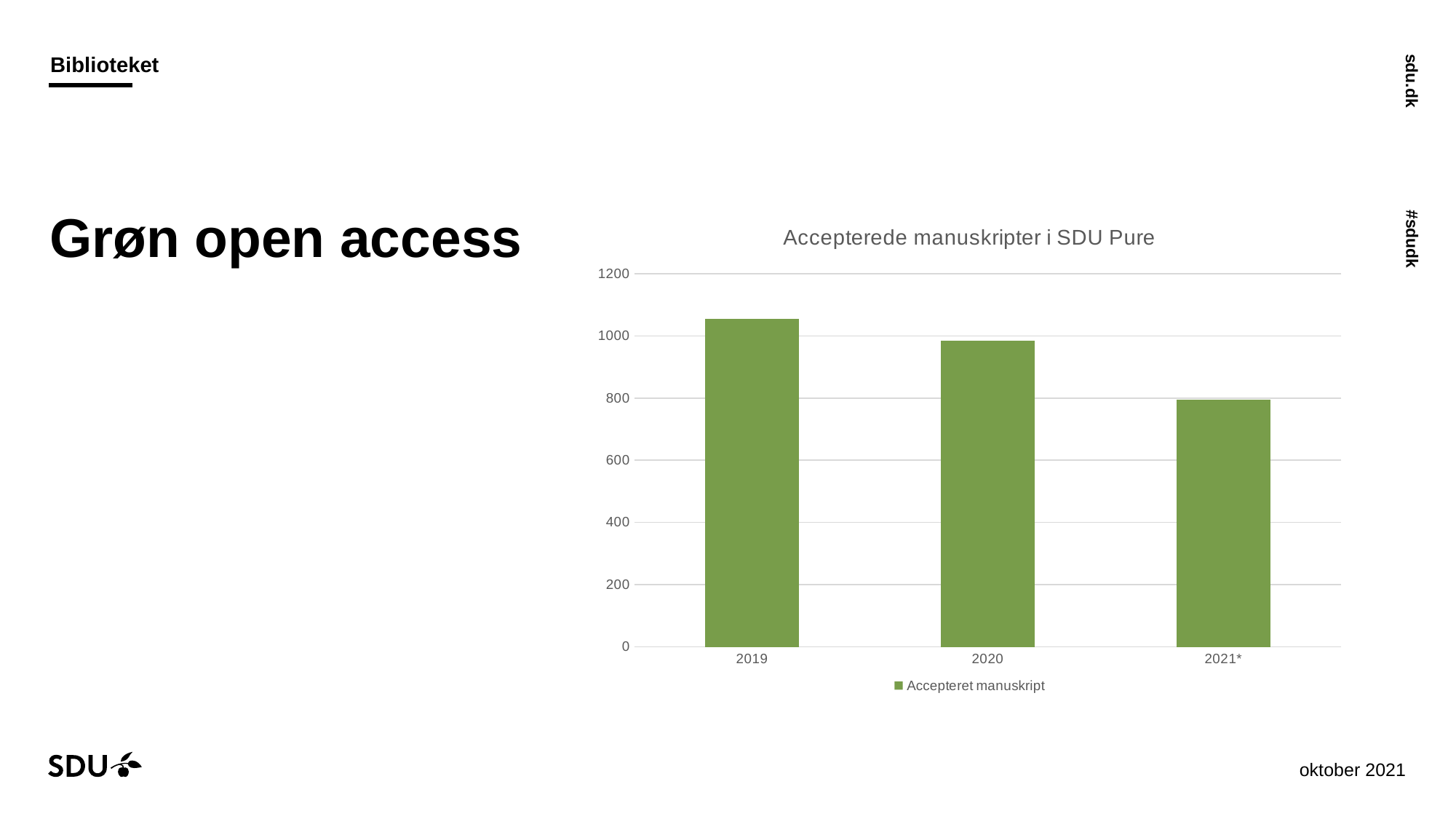
Is the value for 2019 greater or less than 1000? greater Which year has the lowest number of accepted manuscripts? 2021* How many series does the legend list? 1 What kind of chart is shown on the slide? bar chart Do the values rise or fall from 2019 to 2021*? fall What is the title of the chart? Accepterede manuskripter i SDU Pure Is the value for 2021* greater or less than 1000? less What is the name of the series in the legend? Accepteret manuskript Which year has the highest number of accepted manuscripts? 2019 Is the value for 2020 greater or less than 800? greater Which is larger, the value for 2019 or the value for 2021*? 2019 How many years are shown on the x axis of the chart? 3